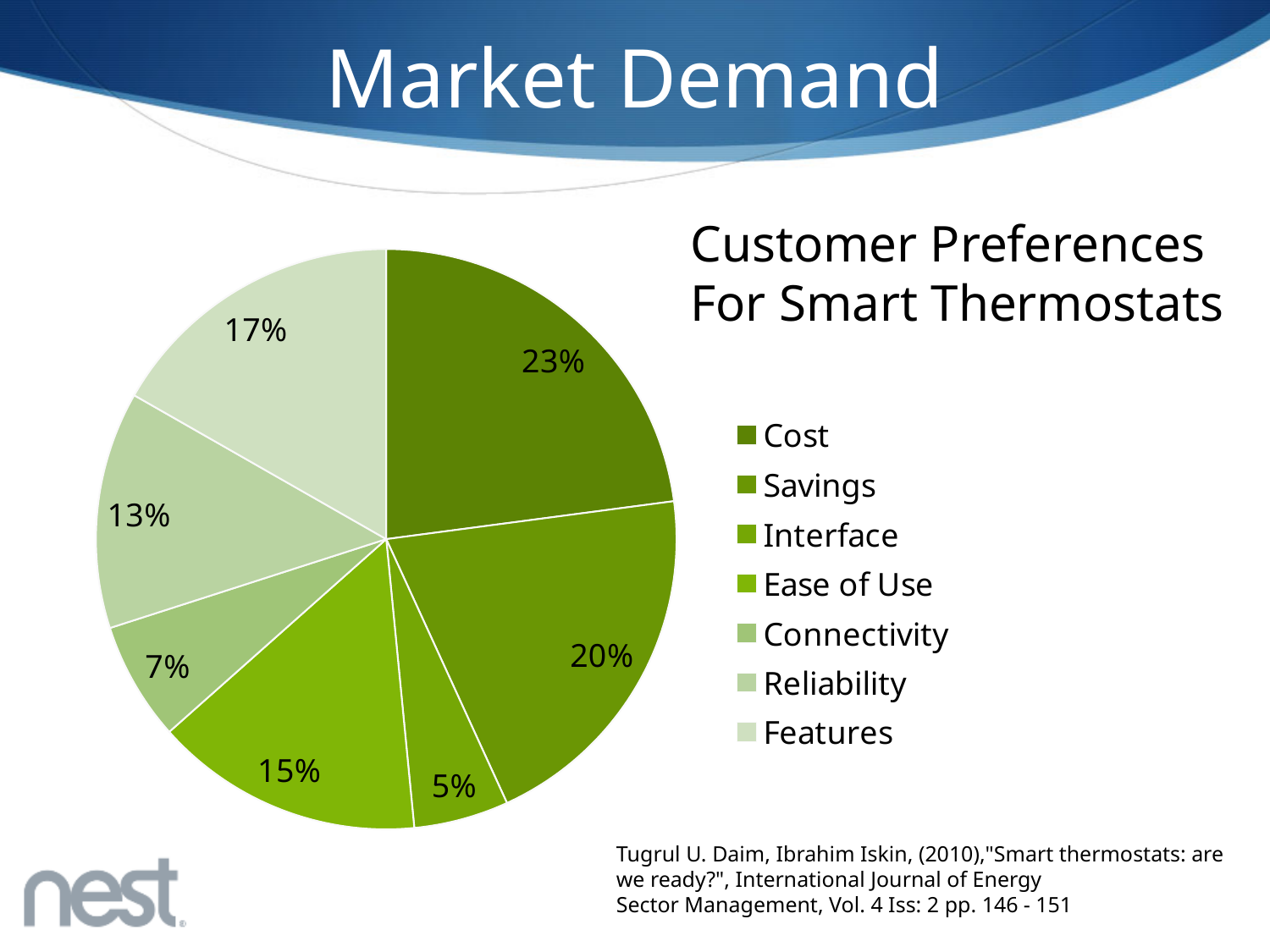
Which category has the largest slice of the pie? Cost What is the difference between the Features and Reliability shares? 4% What is the value for Connectivity? 7% What is the value for Features? 17% What share of the pie does Cost represent? 23% What kind of chart is shown on the slide? pie chart What is the difference between the Cost and Savings shares? 3% What is the title of the pie chart? Customer Preferences For Smart Thermostats What is the value for Savings? 20% How many categories does the pie chart have? 7 Which is larger, Ease of Use or Reliability? Ease of Use Which category has the smallest slice of the pie? Interface